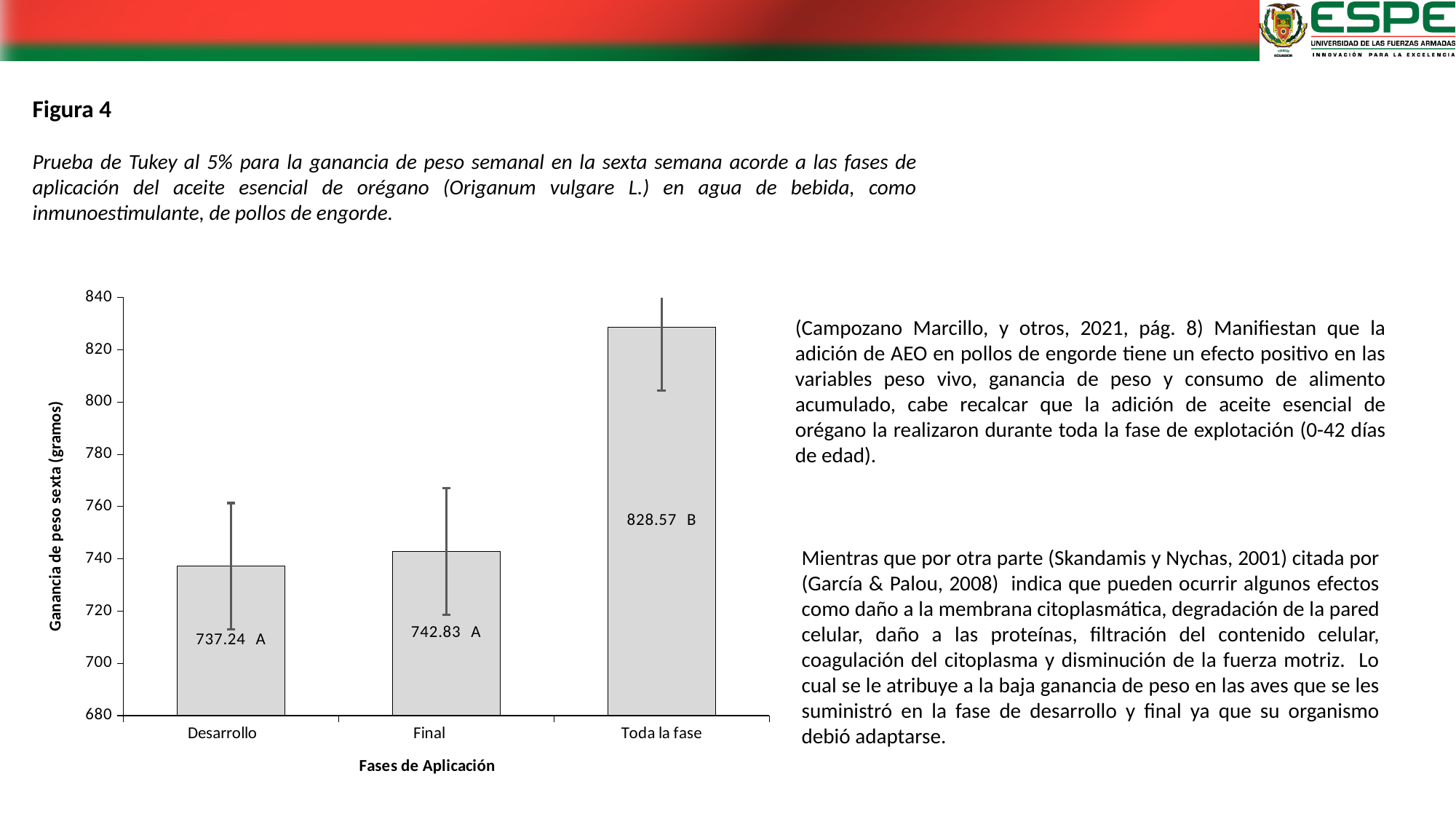
Is the value for Toda la fase greater or less than 800? greater Which application phase has the highest weight gain? Toda la fase Which application phase has the lowest weight gain? Desarrollo What is the label of the y axis? Ganancia de peso sexta (gramos) What is the difference between the values for Final and Desarrollo? 5.59 What is the value for Desarrollo? 737.24 What is the value for Toda la fase? 828.57 What kind of chart is shown on the slide? bar chart Which is larger, the value for Toda la fase or the value for Final? Toda la fase What is the difference between the values for Toda la fase and Desarrollo? 91.33 What is the value for Final? 742.83 How many application phases are shown on the x axis? 3